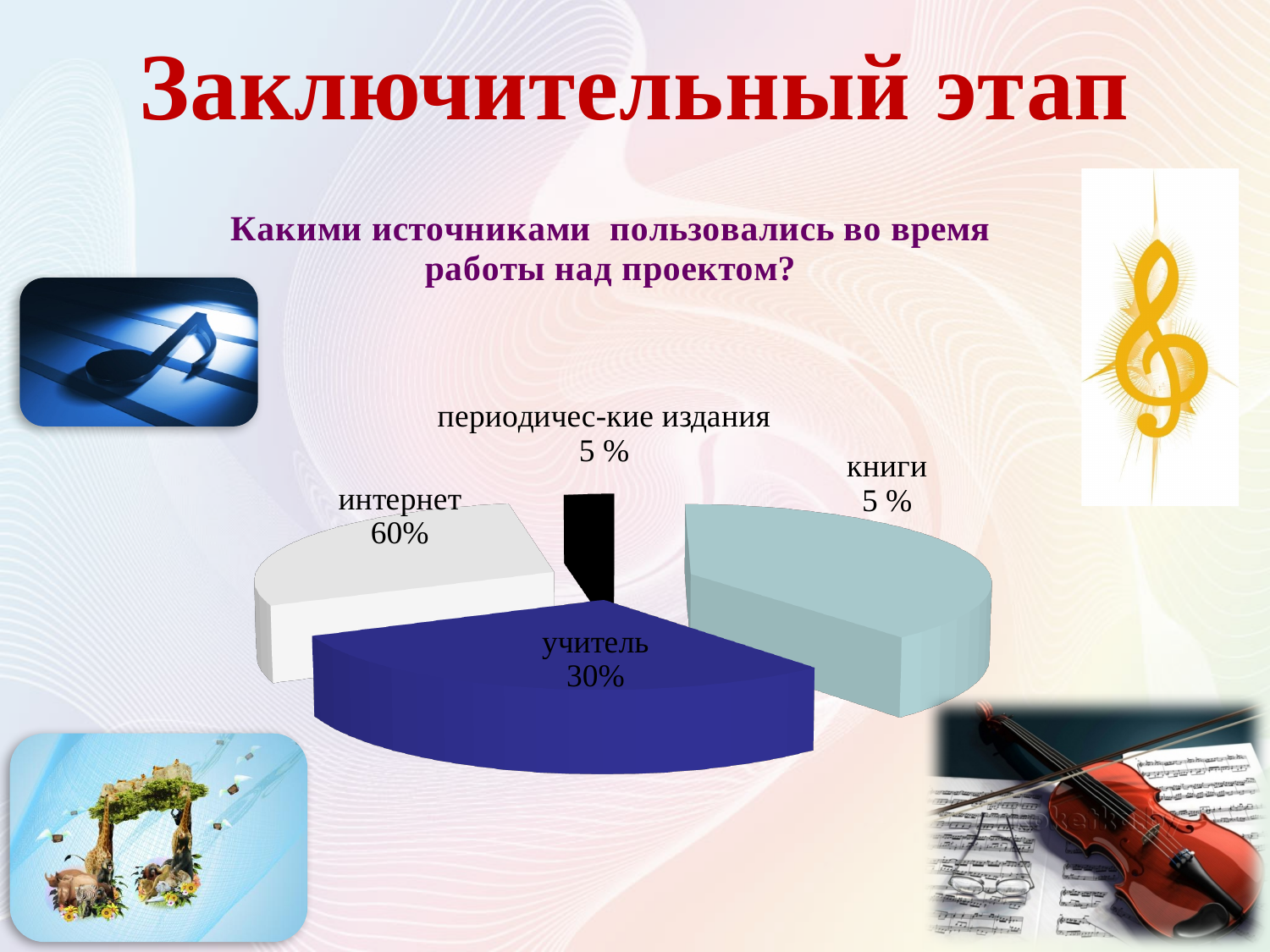
What question does the chart answer, according to the text above it? Какими источниками пользовались во время работы над проектом? What percentage is shown for учитель in the pie chart? 30% What colour is the учитель slice in the pie chart? dark blue What percentage is shown for интернет in the pie chart? 60% What is the difference between the shares for интернет and учитель? 30% What percentage is shown for книги in the pie chart? 5 % What is the difference between the shares for учитель and книги? 25% What kind of chart is shown on the slide? pie chart How many slices does the pie chart have? 4 What percentage is shown for периодичес-кие издания in the pie chart? 5 %